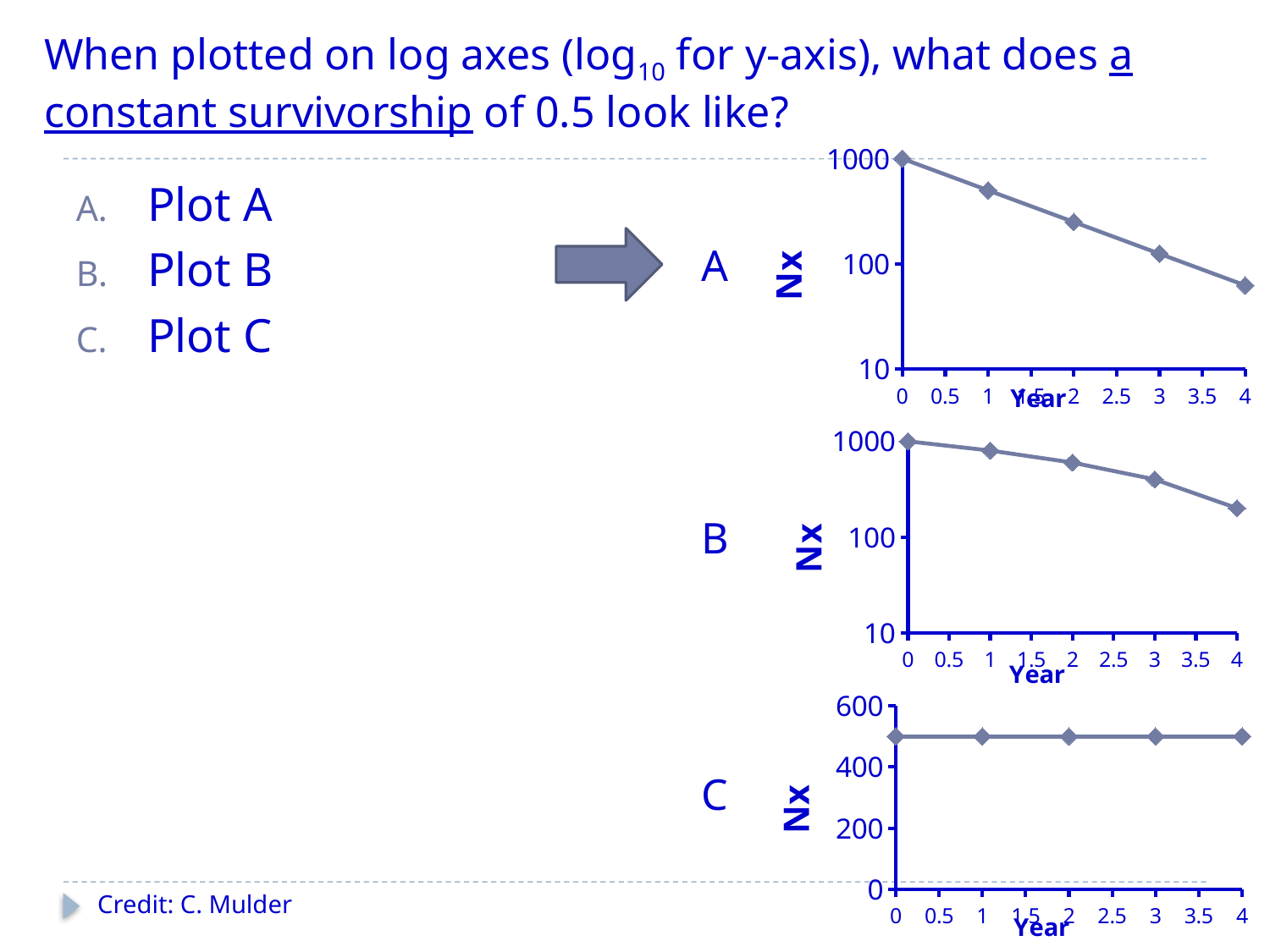
What is the label on the x-axis of Plot C? Year In Plot A, do the values rise or fall as the year increases? fall In Plot B, is the value at year 4 greater or less than 100? greater In Plot A, what is the value of Nx at year 0? 1000 In Plot B, at which year is Nx lowest? 4 In Plot C, do the values rise, fall, or stay flat as the year increases? stay flat What kind of chart is Plot A? line chart In Plot C, is the value at year 2 greater or less than 400? greater In Plot A, is the value at year 4 greater or less than 100? less How many data points are plotted in Plot B? 5 At year 4, which plot has the larger Nx value, Plot A or Plot B? Plot B In Plot B, what is the value of Nx at year 0? 1000